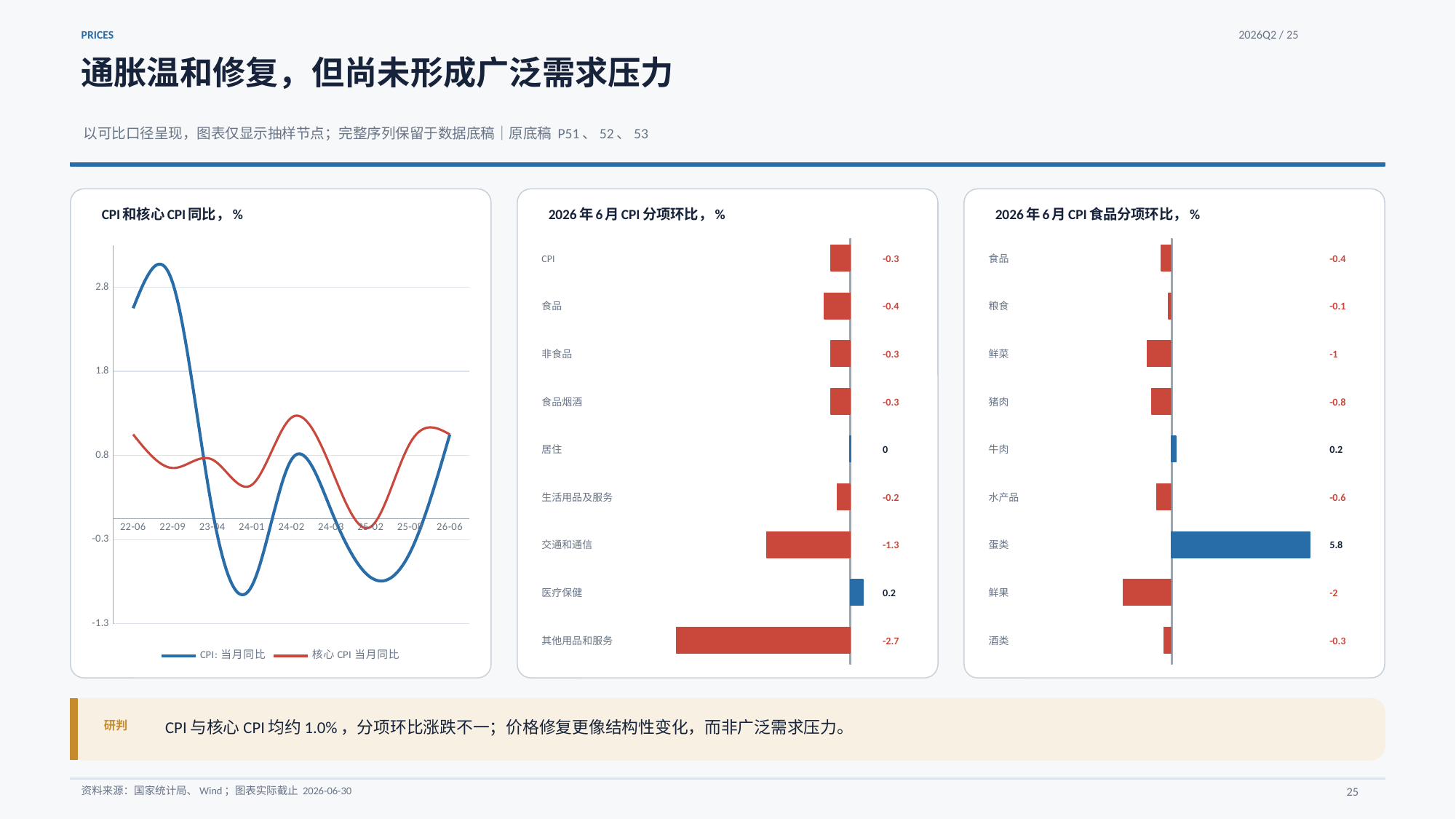
In the chart titled '2026 年 6 月 CPI 食品分项环比，%', what is the value for 蛋类? 5.8 In the chart titled '2026 年 6 月 CPI 分项环比，%', what is the difference between the values for 医疗保健 and 其他用品和服务? 2.9 In the chart titled '2026 年 6 月 CPI 分项环比，%', which category has the highest value? 医疗保健 In the chart titled '2026 年 6 月 CPI 食品分项环比，%', which category has the lowest value? 鲜果 In the chart titled '2026 年 6 月 CPI 食品分项环比，%', what is the difference between the values for 蛋类 and 鲜果? 7.8 In the chart titled '2026 年 6 月 CPI 分项环比，%', how many categories are shown? 9 In the chart titled '2026 年 6 月 CPI 分项环比，%', which category has the lowest value? 其他用品和服务 In the chart titled '2026 年 6 月 CPI 食品分项环比，%', which is larger, the value for 猪肉 or the value for 鲜菜? 猪肉 What kind of chart is the one titled 'CPI 和核心 CPI 同比，%'? line chart How many series does the legend of the chart titled 'CPI 和核心 CPI 同比，%' list? 2 In the chart titled '2026 年 6 月 CPI 分项环比，%', what is the value for 交通和通信? -1.3